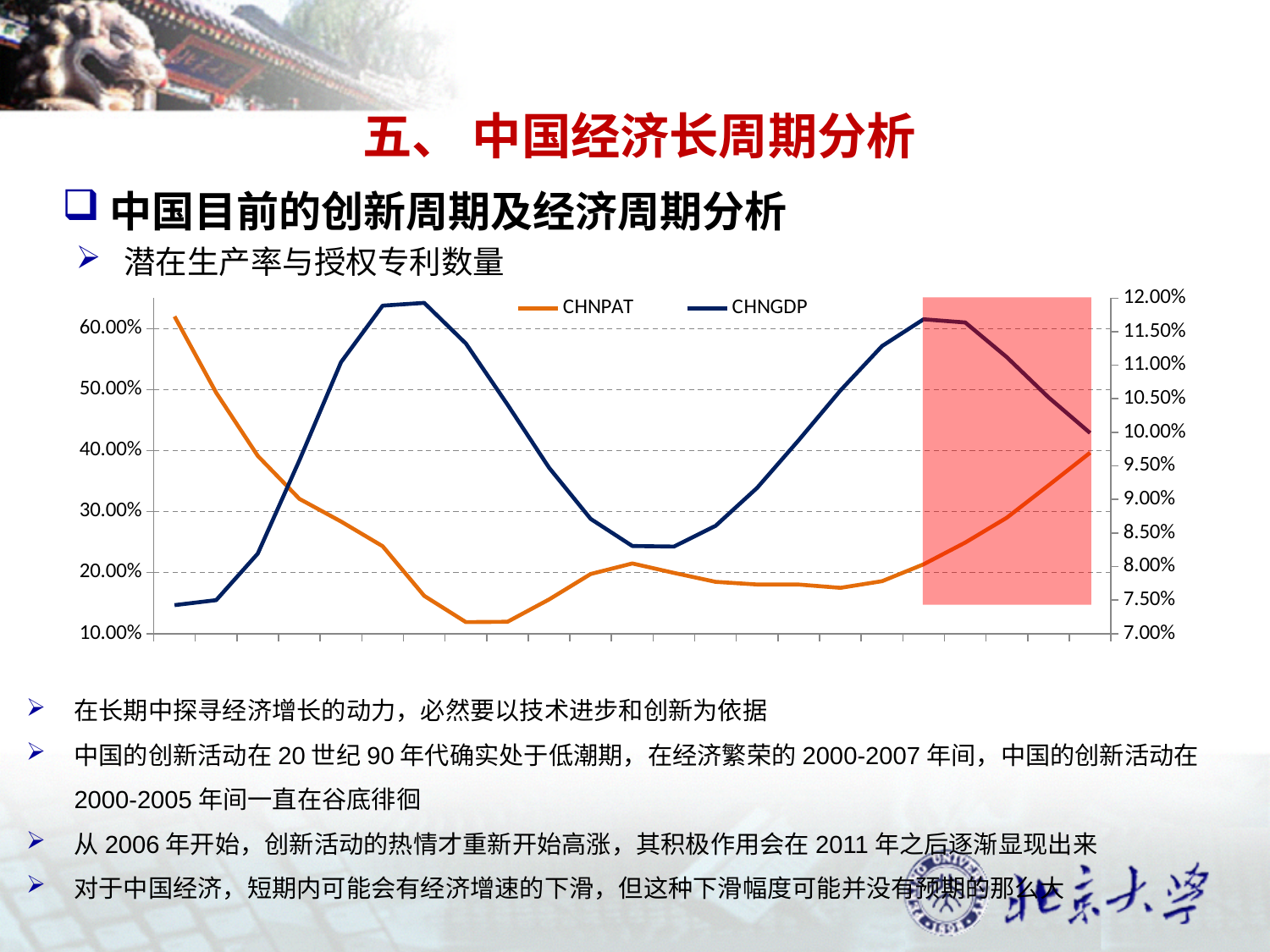
Which series is drawn in orange? CHNPAT Is the first plotted value of CHNGDP greater or less than 8.00%? less Is the first plotted value of CHNPAT greater or less than 50.00%? greater Is the last plotted value of CHNPAT greater or less than 50.00%? less Within the shaded region at the right of the chart, does the CHNGDP line rise or fall? fall How many series does the chart legend list? 2 What are the two series named in the chart legend? CHNPAT and CHNGDP What is the highest tick label on the right-hand vertical axis? 12.00% Within the shaded region at the right of the chart, does the CHNPAT line rise or fall? rise Does the CHNPAT line rise or fall over the first few points from the left? fall What kind of chart is shown on the slide? line chart